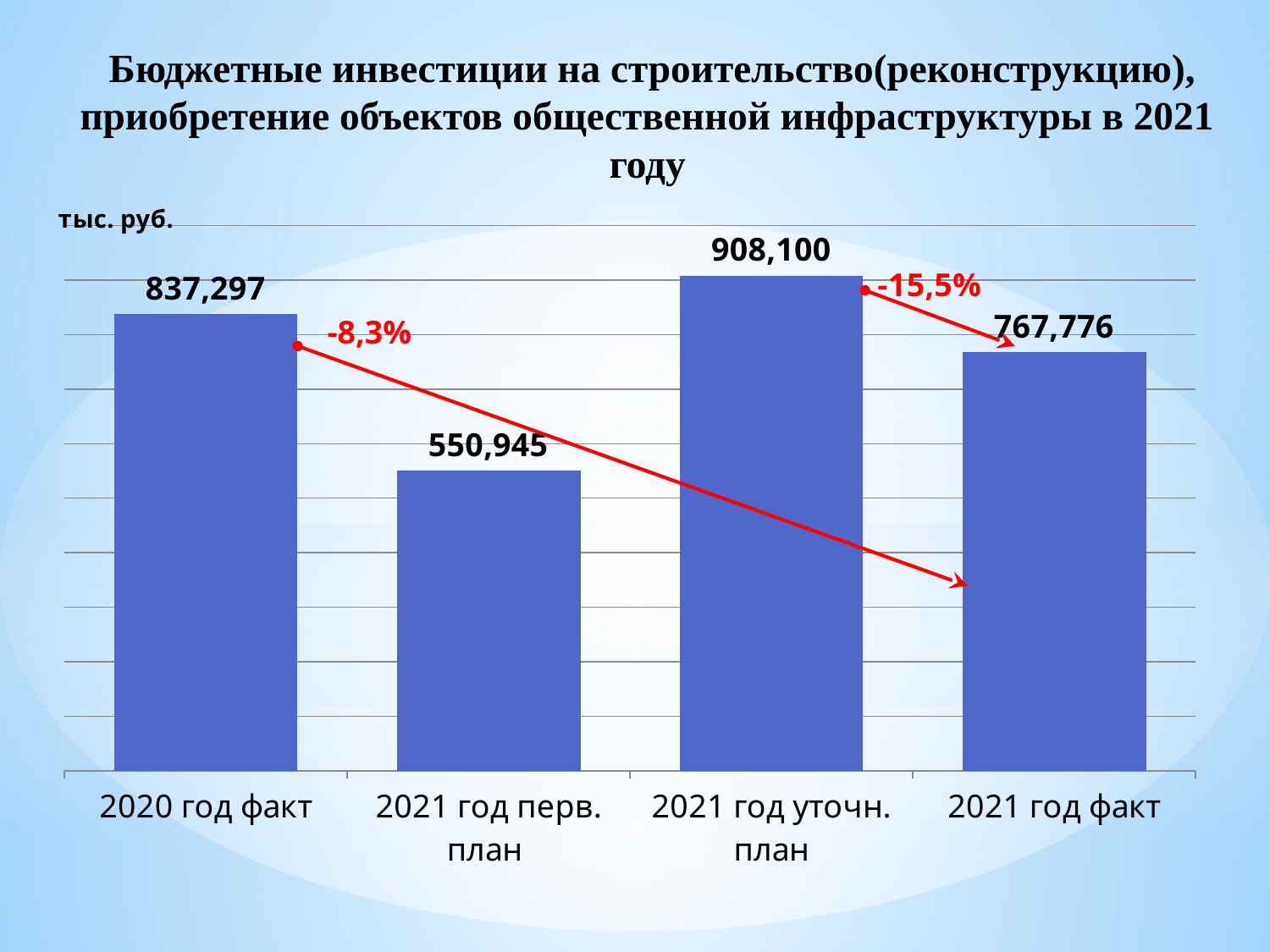
What unit is indicated for the values in the chart? тыс. руб. What is the difference between the values for 2021 год уточн. план and 2021 год факт? 140,324 Which category has the highest value? 2021 год уточн. план What is the value for 2021 год уточн. план? 908,100 How many categories are shown in the chart? 4 Which category has the lowest value? 2021 год перв. план Which is larger, the value for 2020 год факт or the value for 2021 год факт? 2020 год факт What is the value for 2021 год перв. план? 550,945 What is the difference between the values for 2020 год факт and 2021 год факт? 69,521 What is the value for 2021 год факт? 767,776 What is the value for 2020 год факт? 837,297 What kind of chart is shown on the slide? Bar chart